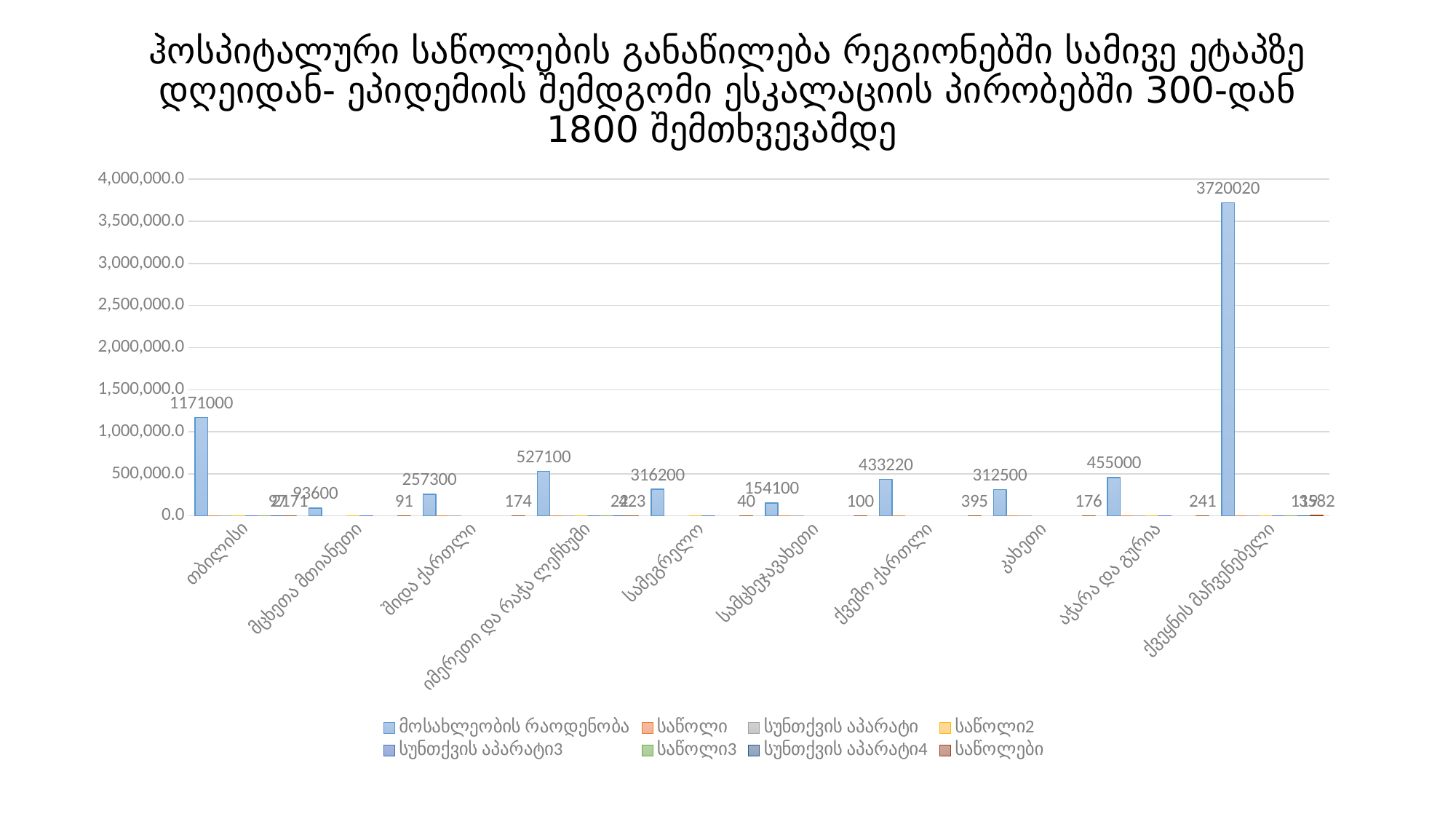
What is the first series listed in the legend? მოსახლეობის რაოდენობა What kind of chart is shown on the slide? bar chart Which category has the lowest value of მოსახლეობის რაოდენობა? მცხეთა მთიანეთი What is the value of მოსახლეობის რაოდენობა for კახეთი? 312500 What is the value of მოსახლეობის რაოდენობა for თბილისი? 1171000 What is the value of მოსახლეობის რაოდენობა for ქვეყნის მაჩვენებელი? 3720020 How many series does the legend list? 8 How many categories (regions) are shown along the x axis? 10 Is the მოსახლეობის რაოდენობა value for იმერეთი და რაჭა ლეჩხუმი greater or less than 500,000? greater Which has the larger მოსახლეობის რაოდენობა value: ქვემო ქართლი or აჭარა და გურია? აჭარა და გურია What is the difference in მოსახლეობის რაოდენობა between თბილისი and შიდა ქართლი? 913700 Which category has the highest value of მოსახლეობის რაოდენობა? ქვეყნის მაჩვენებელი